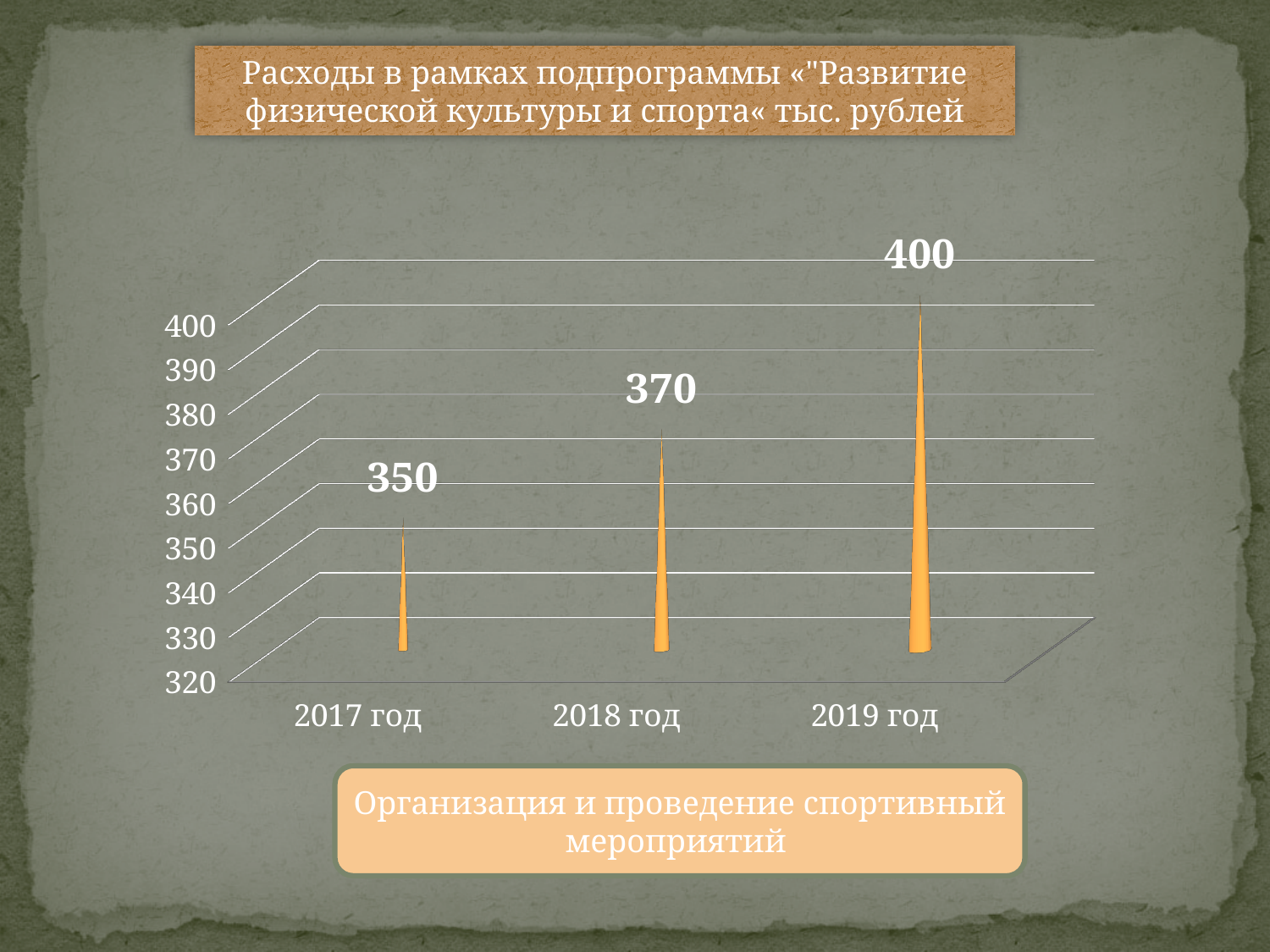
Which year has the lowest value? 2017 год How many categories are shown on the x axis? 3 What is the difference between the values for 2019 год and 2017 год? 50 What kind of chart is shown on the slide? bar chart What is the value for 2017 год? 350 Which year has the highest value? 2019 год What is the value for 2018 год? 370 What is the value for 2019 год? 400 What is the difference between the values for 2018 год and 2017 год? 20 Which is larger, the value for 2018 год or the value for 2019 год? 2019 год Do the values rise or fall from 2017 год to 2019 год? rise What is the unit of measurement stated in the chart title? тыс. рублей